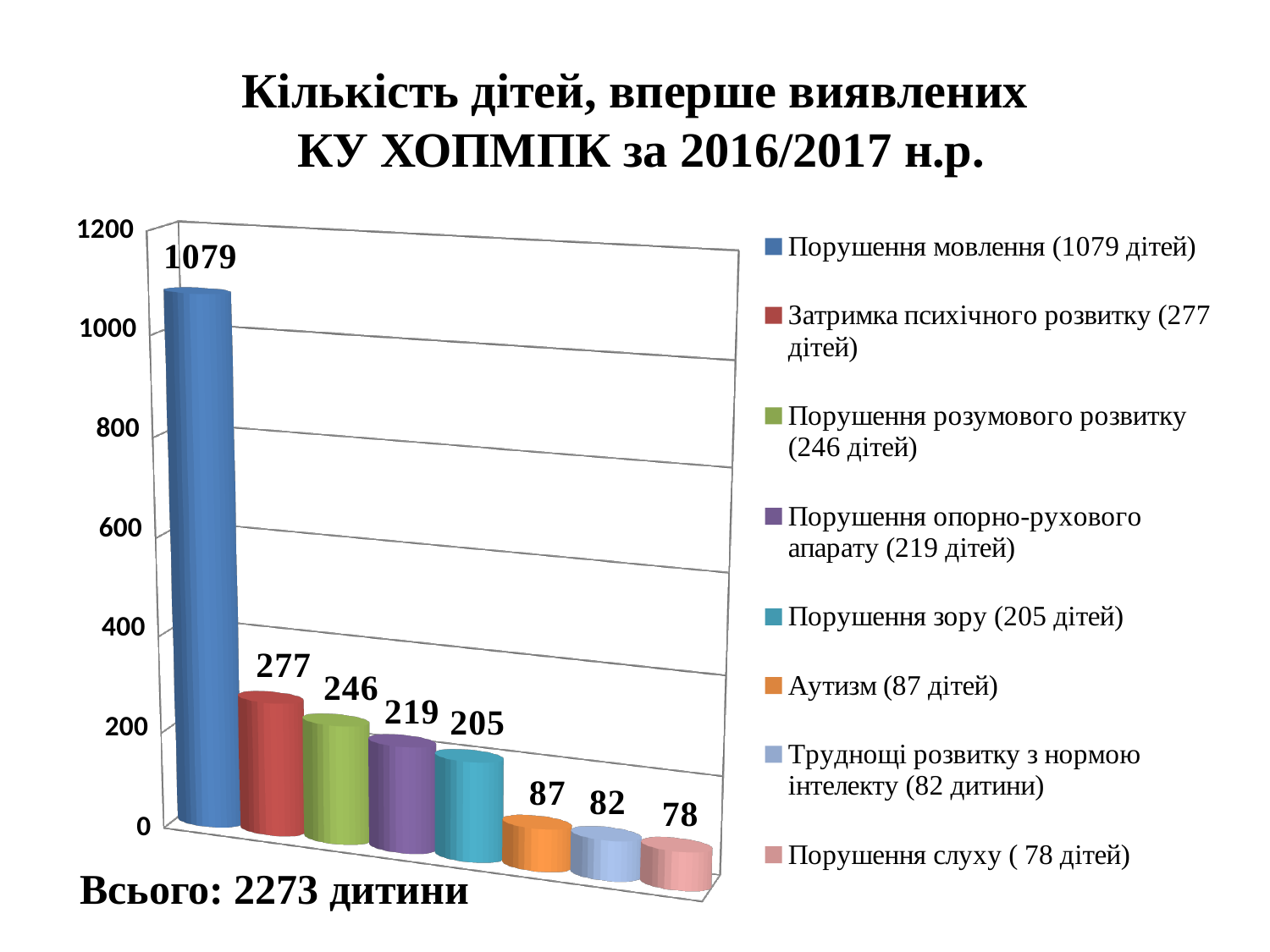
Which category has the lowest value? Порушення слуху How many entries does the legend list? 8 What is the difference between the values for Порушення розумового розвитку and Порушення опорно-рухового апарату? 27 What kind of chart is shown on the slide? bar chart Which is larger, the value for Затримка психічного розвитку or the value for Порушення зору? Затримка психічного розвитку What total number of children is stated below the chart? 2273 дитини What is the value for Порушення мовлення? 1079 What is the value for Аутизм? 87 What is the value for Порушення зору? 205 How many categories are shown in the chart? 8 What is the value for Затримка психічного розвитку? 277 Which category has the highest value? Порушення мовлення